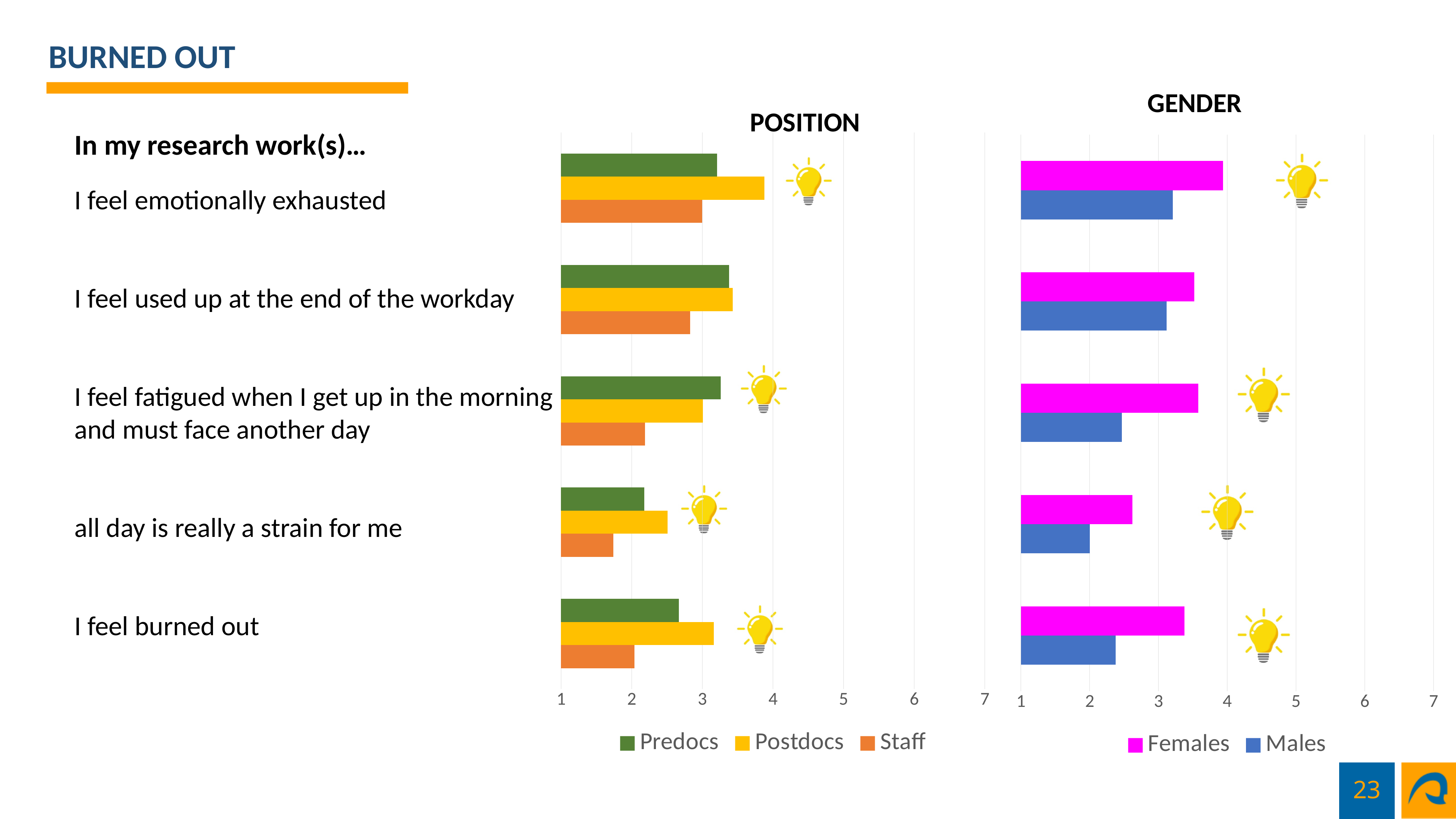
In the GENDER chart, is the Females value for 'I feel emotionally exhausted' greater or less than 3? greater How many series does the legend of the GENDER chart list? 2 In the POSITION chart, is the Postdocs value for 'I feel emotionally exhausted' greater or less than 3? greater In the POSITION chart, which statement has the lowest Staff value? all day is really a strain for me How many statements (categories) are plotted in the GENDER chart? 5 In the GENDER chart, which statement has the highest Females value? I feel emotionally exhausted In the POSITION chart, which is larger for 'I feel burned out': Postdocs or Staff? Postdocs In the GENDER chart, is the Males value for 'I feel fatigued when I get up in the morning and must face another day' greater or less than 3? less In the GENDER chart, which is larger for 'I feel burned out': Females or Males? Females What kind of chart is the POSITION chart? bar chart How many series does the legend of the POSITION chart list? 3